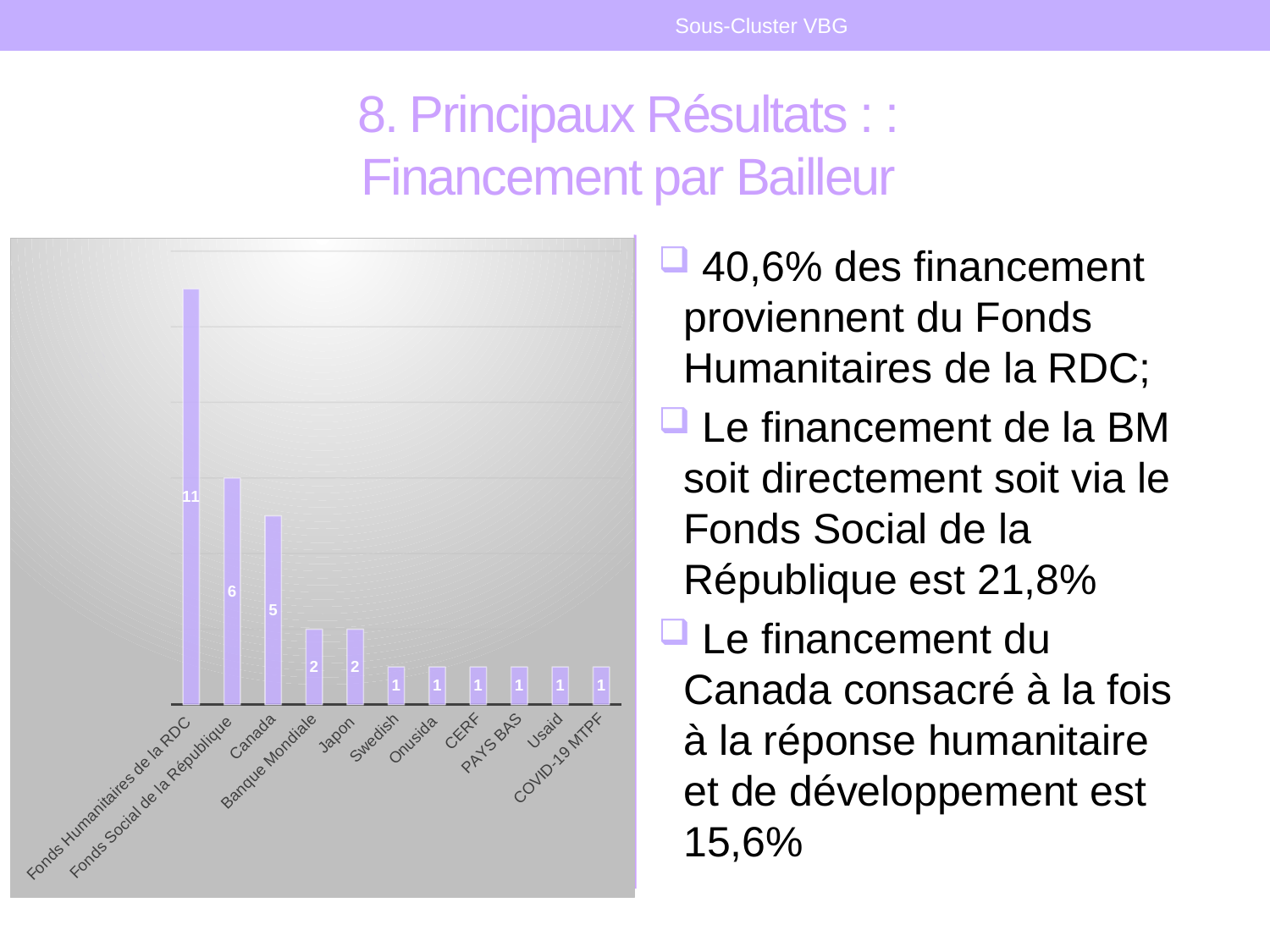
What is the value for CERF? 1 Which is larger, the value for Canada or the value for Banque Mondiale? Canada Which category has the highest value? Fonds Humanitaires de la RDC What is the difference between the values for Fonds Humanitaires de la RDC and Fonds Social de la République? 5 How many categories are shown on the x axis? 11 What is the value for Banque Mondiale? 2 What is the difference between the values for Canada and Japon? 3 What is the value for Fonds Social de la République? 6 What type of chart is shown on the slide? bar chart What is the value for Fonds Humanitaires de la RDC? 11 Do the values rise or fall moving from left to right along the x axis? fall What is the value for Canada? 5